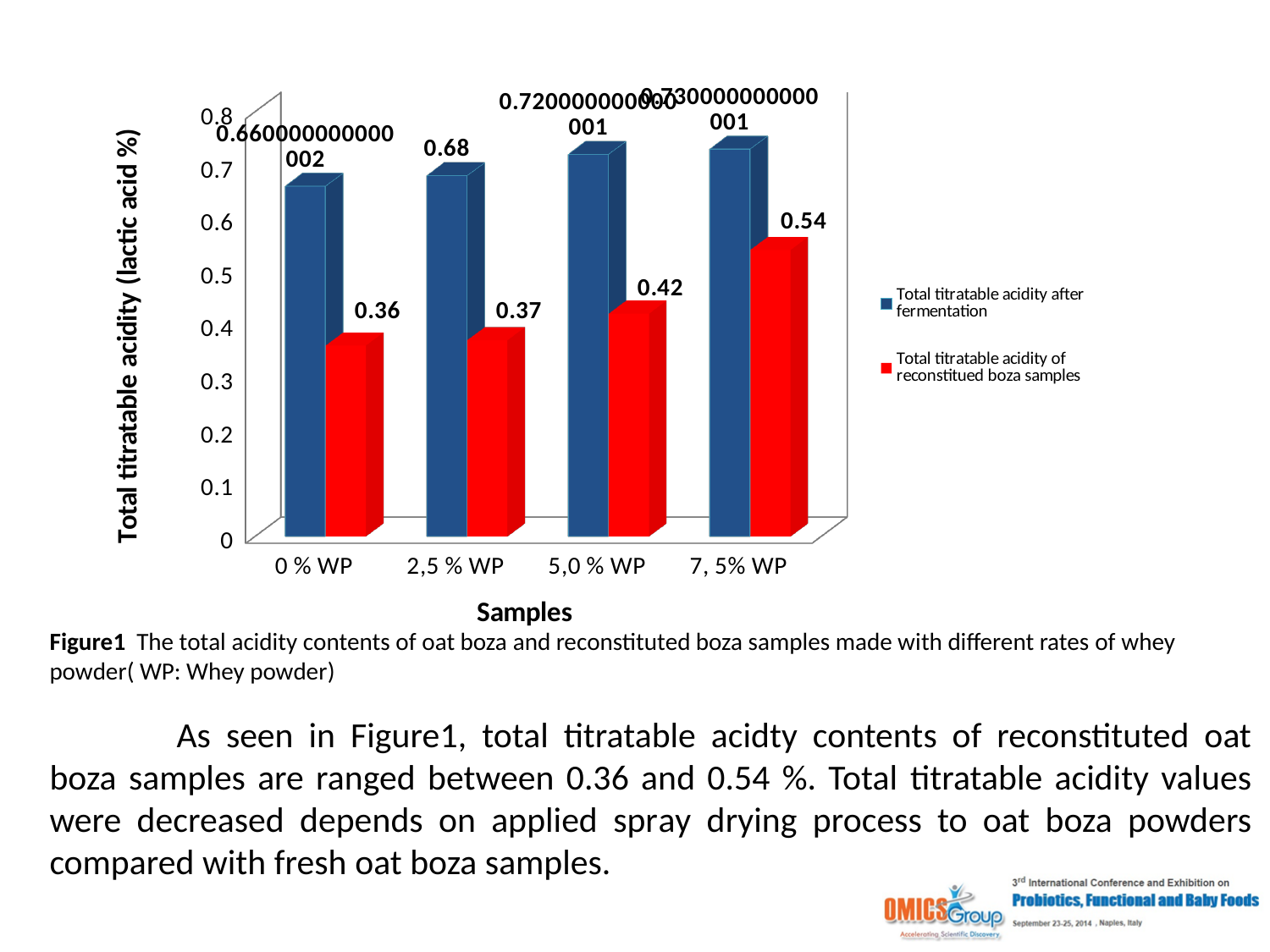
What is the total titratable acidity of reconstitued boza samples for 0 % WP? 0.36 What is the difference between the reconstitued boza sample values for 7, 5% WP and 0 % WP? 0.18 For 5,0 % WP, which is larger: total titratable acidity after fermentation or total titratable acidity of reconstitued boza samples? Total titratable acidity after fermentation What is the total titratable acidity of reconstitued boza samples for 7, 5% WP? 0.54 Is the total titratable acidity after fermentation for 7, 5% WP greater or less than 0.6? greater What is the total titratable acidity after fermentation for 2,5 % WP? 0.68 Do the total titratable acidity values of reconstitued boza samples rise or fall from 0 % WP to 7, 5% WP? rise Which sample has the highest total titratable acidity of reconstitued boza samples? 7, 5% WP Which sample has the lowest total titratable acidity of reconstitued boza samples? 0 % WP How many series does the legend list? 2 How many samples are shown on the x axis? 4 What is the difference between the reconstitued boza sample values for 5,0 % WP and 2,5 % WP? 0.05